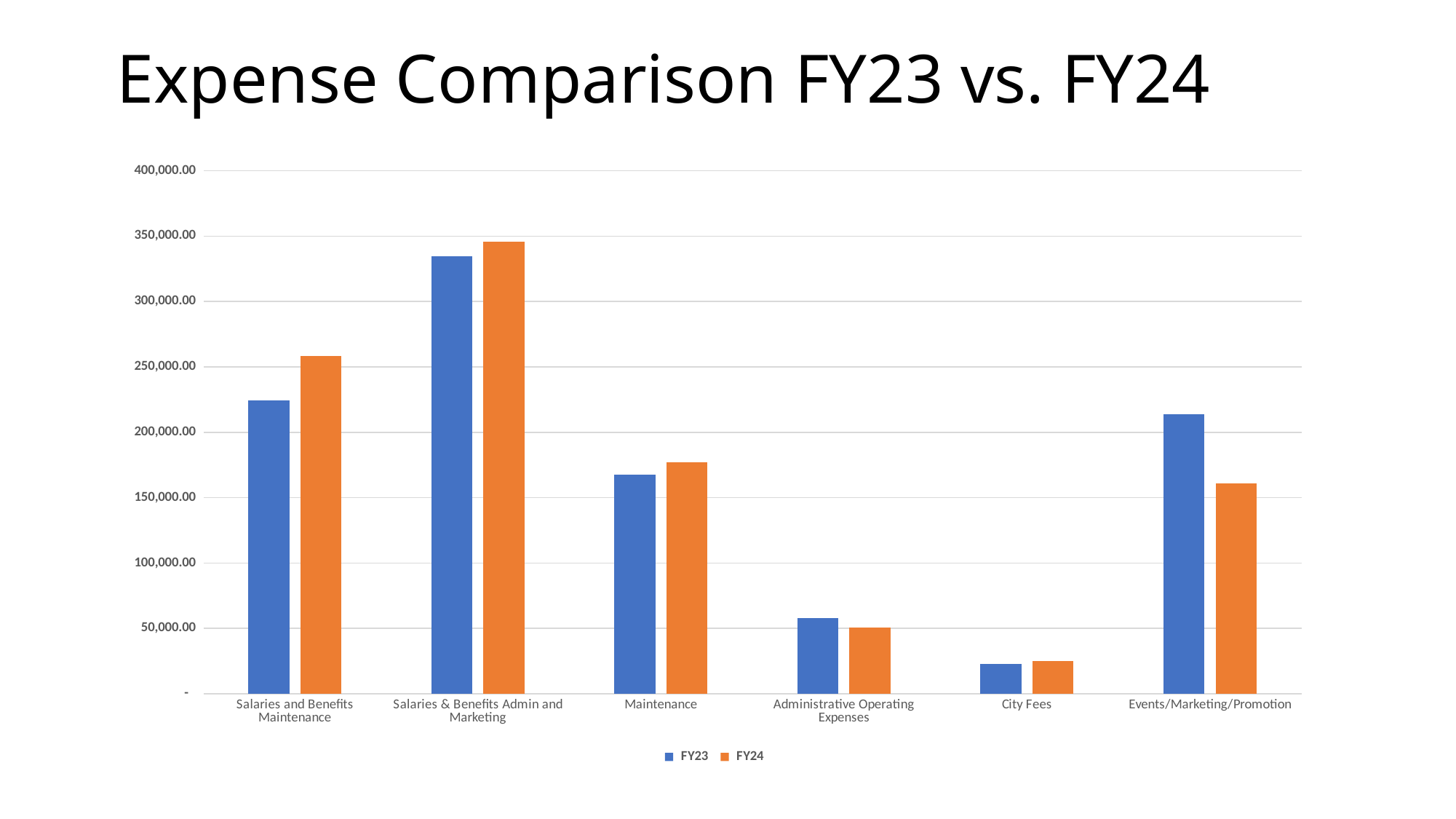
What kind of chart is shown on the slide? Bar chart For Salaries and Benefits Maintenance, which is larger, FY23 or FY24? FY24 Is the FY23 value for City Fees greater or less than 50,000.00? less How many expense categories are shown on the x axis? 6 For Events/Marketing/Promotion, which is larger, FY23 or FY24? FY23 How many series does the legend list? 2 What colour are the FY24 bars? Orange Which category has the highest FY23 value? Salaries & Benefits Admin and Marketing Which category has the lowest FY24 value? City Fees Is the FY23 value for Events/Marketing/Promotion greater or less than 200,000.00? greater Is the FY24 value for Salaries and Benefits Maintenance greater or less than 250,000.00? greater Which category has the highest FY24 value? Salaries & Benefits Admin and Marketing